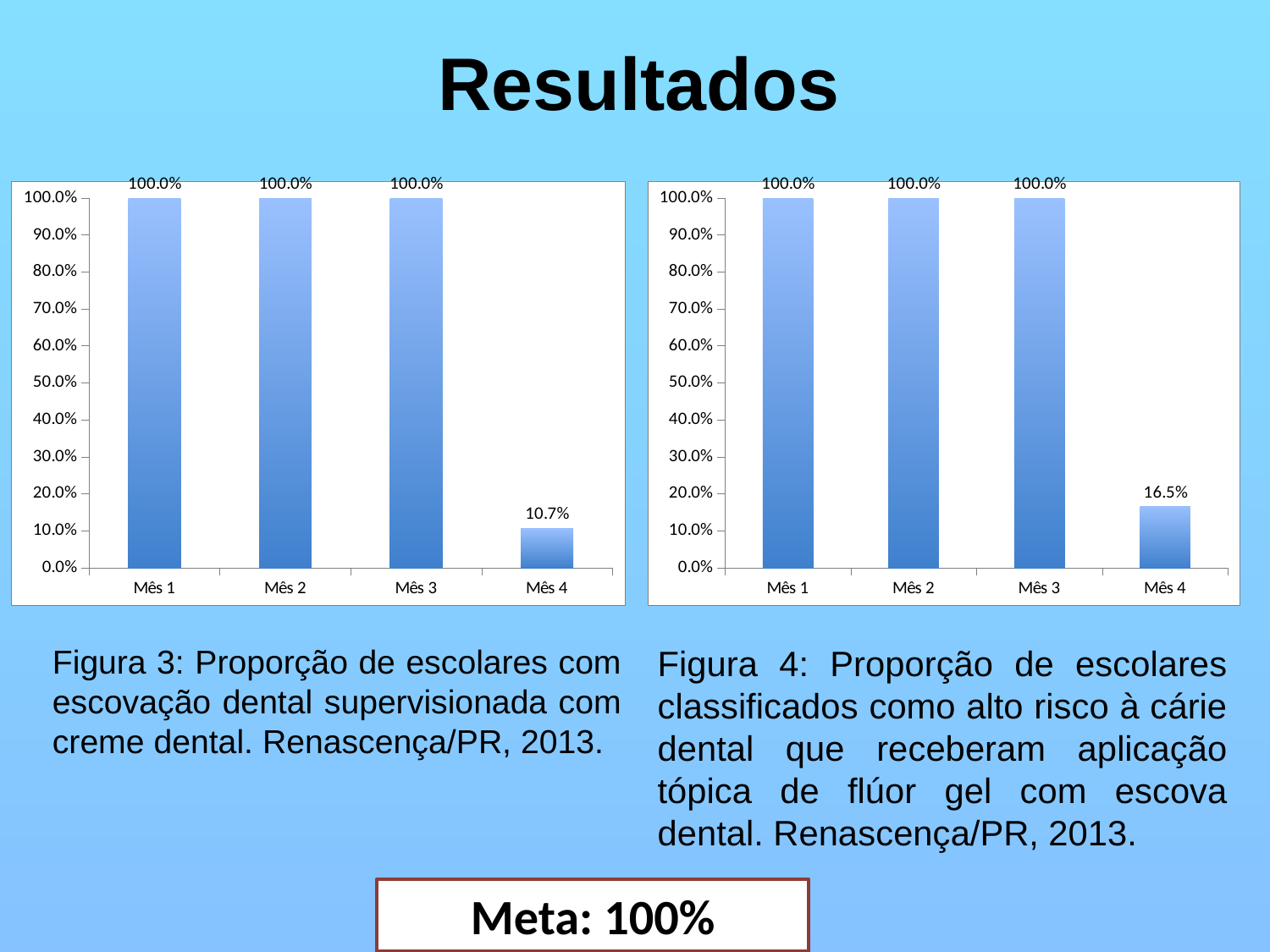
In the right chart (Figura 4), what is the value for Mês 4? 16.5% In the left chart (Figura 3), what is the difference between the values for Mês 3 and Mês 4? 89.3% In the left chart (Figura 3), is the value for Mês 4 greater or less than 20.0%? less In the left chart (Figura 3), what is the value for Mês 4? 10.7% What type of chart is the right chart (Figura 4)? Bar chart How many months are shown on the x axis of the left chart (Figura 3)? 4 In the right chart (Figura 4), what is the difference between the values for Mês 1 and Mês 4? 83.5% In the right chart (Figura 4), which month has the lowest value? Mês 4 In the left chart (Figura 3), which month has the lowest value? Mês 4 In the right chart (Figura 4), what is the value for Mês 1? 100.0% In the left chart (Figura 3), what is the value for Mês 2? 100.0% Which is larger: the Mês 4 value in the left chart (Figura 3) or the Mês 4 value in the right chart (Figura 4)? Right chart (Figura 4)